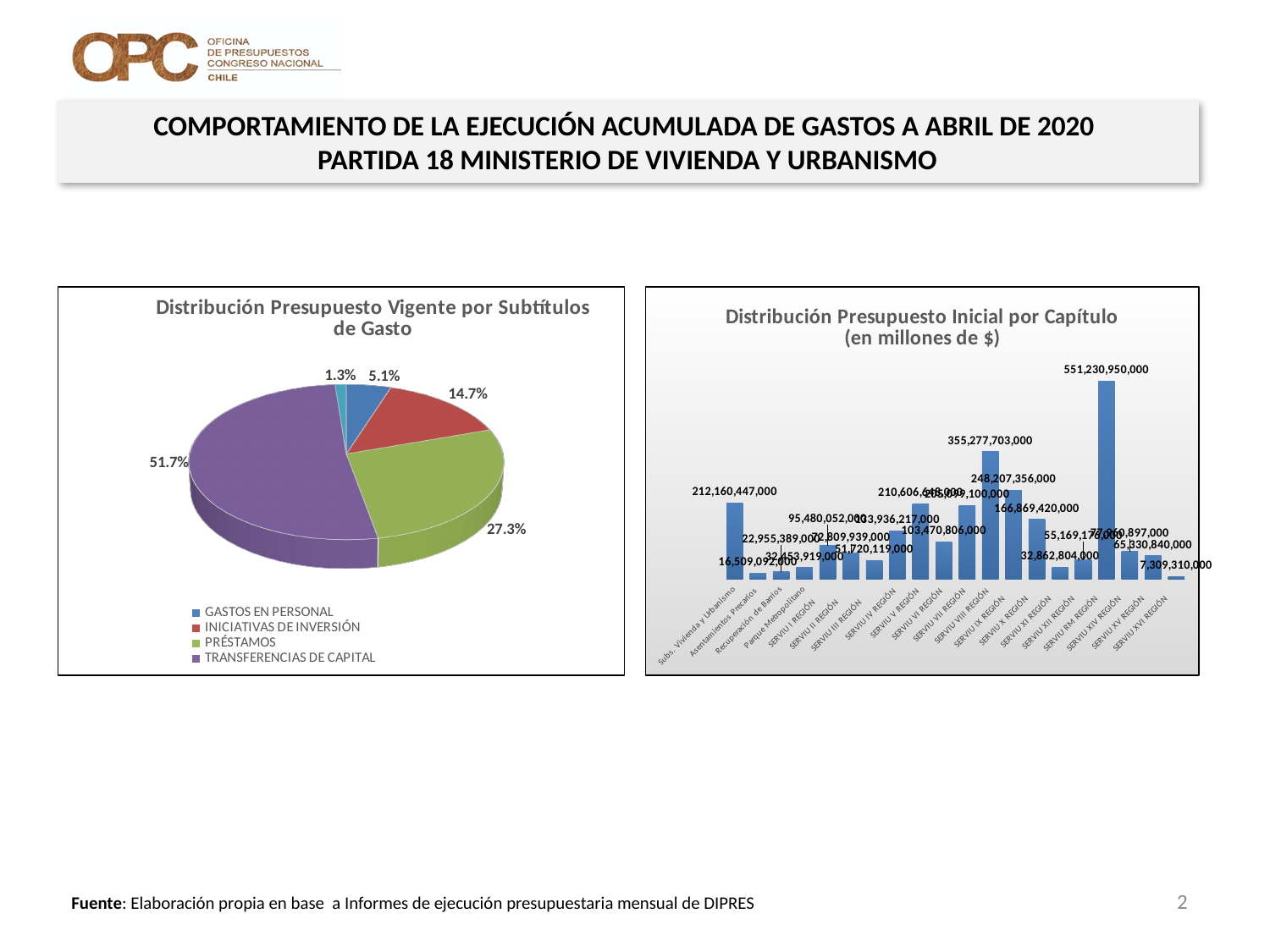
In the chart 'Distribución Presupuesto Vigente por Subtítulos de Gasto', what share of the pie is INICIATIVAS DE INVERSIÓN? 14.7% In the chart 'Distribución Presupuesto Inicial por Capítulo', what is the value for SERVIU VIII REGIÓN? 355,277,703,000 In the chart 'Distribución Presupuesto Vigente por Subtítulos de Gasto', what share of the pie is PRÉSTAMOS? 27.3% How many entries does the legend of the chart 'Distribución Presupuesto Vigente por Subtítulos de Gasto' list? 4 In the chart 'Distribución Presupuesto Inicial por Capítulo', what is the value for SERVIU XVI REGIÓN? 7,309,310,000 In the chart 'Distribución Presupuesto Inicial por Capítulo', which is larger: the value for SERVIU IX REGIÓN or the value for SERVIU X REGIÓN? SERVIU IX REGIÓN What kind of chart is 'Distribución Presupuesto Vigente por Subtítulos de Gasto'? Pie chart In the chart 'Distribución Presupuesto Vigente por Subtítulos de Gasto', what share of the pie is TRANSFERENCIAS DE CAPITAL? 51.7% What kind of chart is 'Distribución Presupuesto Inicial por Capítulo (en millones de $)'? Bar chart How many categories are shown in the chart 'Distribución Presupuesto Inicial por Capítulo'? 20 In the chart 'Distribución Presupuesto Inicial por Capítulo', which category has the highest value? SERVIU RM REGIÓN In the chart 'Distribución Presupuesto Vigente por Subtítulos de Gasto', which legend entry has the largest share? TRANSFERENCIAS DE CAPITAL